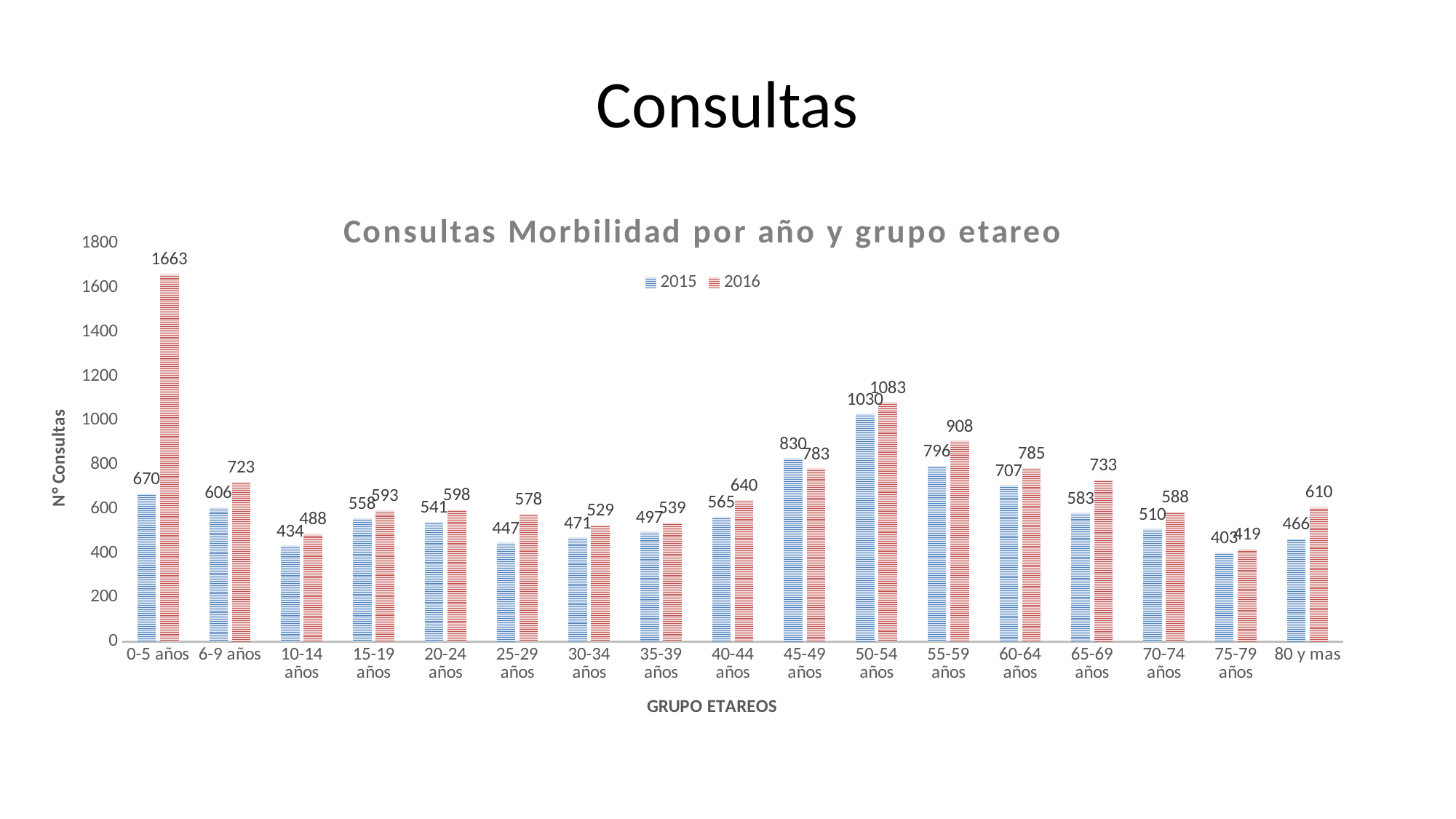
What is the 2016 value for the 80 y mas group? 610 What is the difference between the 2015 and 2016 values for the 45-49 años group? 47 For the 45-49 años group, which year has the larger value, 2015 or 2016? 2015 Which age group has the highest 2016 value? 0-5 años What is the 2015 value for the 50-54 años group? 1030 What is the 2016 value for the 0-5 años group? 1663 What is the title of the chart? Consultas Morbilidad por año y grupo etareo What kind of chart is shown on the slide? Bar chart What is the difference between the 2016 and 2015 values for the 0-5 años group? 993 How many series does the legend list? 2 Which age group has the lowest 2015 value? 75-79 años How many age groups are shown on the x axis? 17